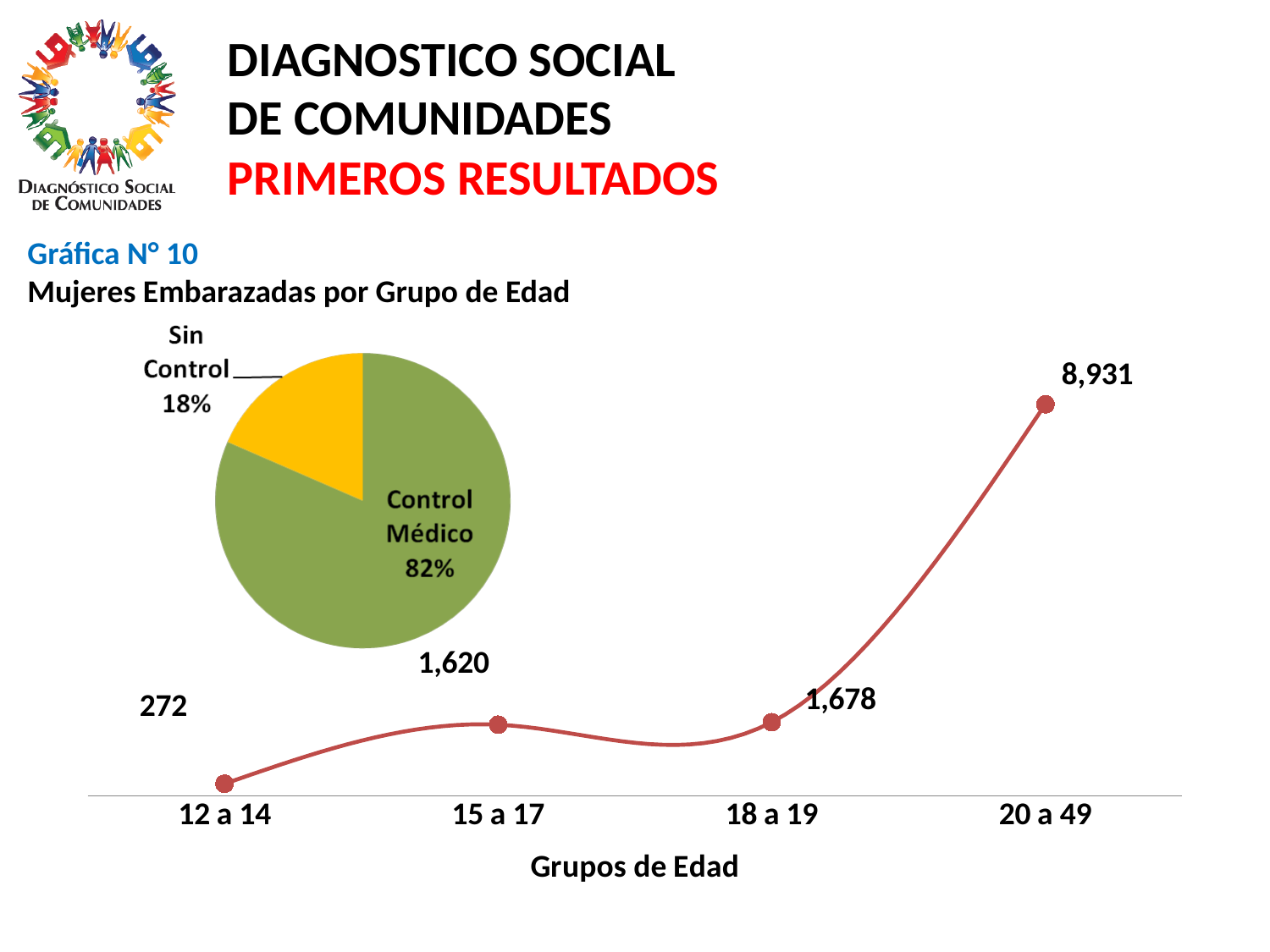
In the line chart 'Mujeres Embarazadas por Grupo de Edad', what is the difference between the values for 20 a 49 and 18 a 19? 7,253 In the pie chart, what share is labelled 'Sin Control'? 18% In the line chart 'Mujeres Embarazadas por Grupo de Edad', how many age groups are plotted? 4 What kind of chart is the chart at the bottom of the slide showing values by 'Grupos de Edad'? Line chart In the line chart 'Mujeres Embarazadas por Grupo de Edad', what is the value for the age group 20 a 49? 8,931 In the pie chart, which slice is larger, 'Control Médico' or 'Sin Control'? Control Médico In the line chart 'Mujeres Embarazadas por Grupo de Edad', what is the value for the age group 15 a 17? 1,620 In the pie chart, what share is labelled 'Control Médico'? 82% In the line chart 'Mujeres Embarazadas por Grupo de Edad', which age group has the highest value? 20 a 49 In the line chart 'Mujeres Embarazadas por Grupo de Edad', what is the value for the age group 18 a 19? 1,678 In the line chart 'Mujeres Embarazadas por Grupo de Edad', what is the value for the age group 12 a 14? 272 In the line chart 'Mujeres Embarazadas por Grupo de Edad', which age group has the lowest value? 12 a 14